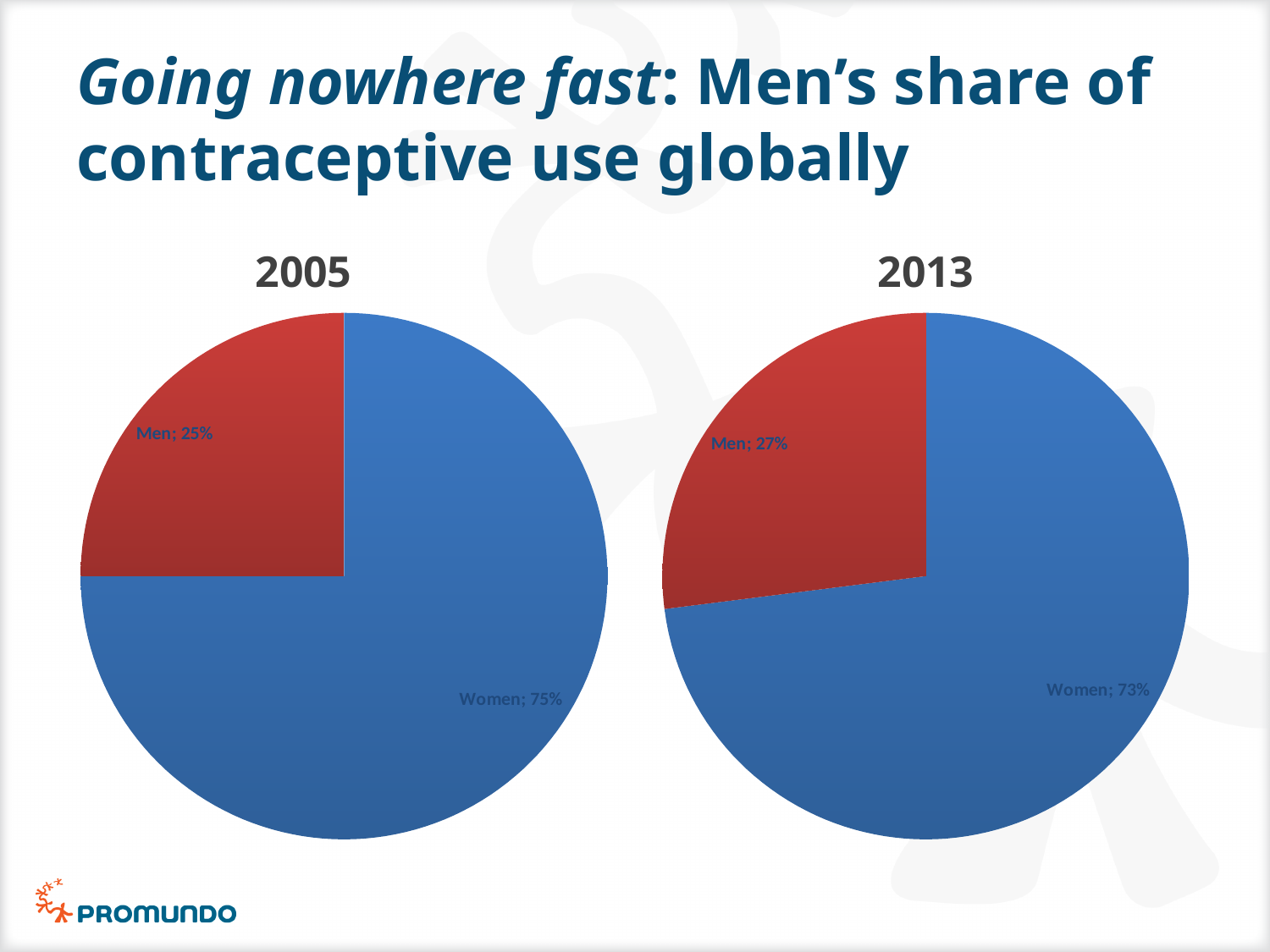
How many slices does the 2005 pie chart have? 2 What colour is the Men slice in both pie charts? Red Is the Men's share larger in the 2005 pie chart or the 2013 pie chart? 2013 In the 2013 pie chart, which slice is the largest? Women What type of chart is used to show the 2013 data? Pie chart In the 2005 pie chart, what share is labelled for Women? 75% In the 2005 pie chart, what share is labelled for Men? 25% In the 2013 pie chart, what share is labelled for Men? 27% In the 2005 pie chart, which slice is the smallest? Men What is the difference in percentage points between the Men's share in 2013 and the Men's share in 2005? 2 percentage points In the 2013 pie chart, what share is labelled for Women? 73% What is the title of the slide containing the two pie charts? Going nowhere fast: Men's share of contraceptive use globally